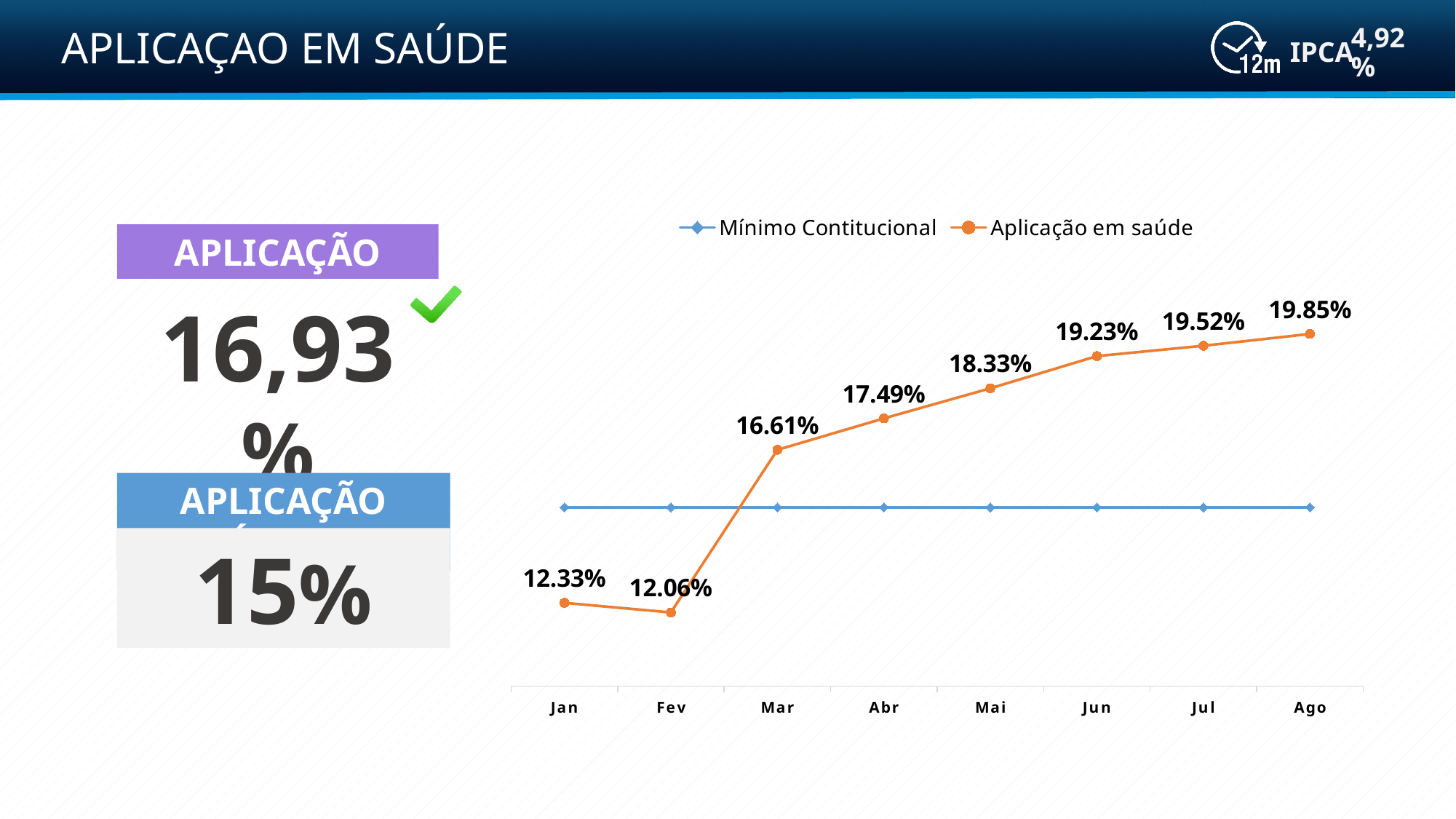
In which month is Aplicação em saúde highest? Ago Which series in the legend is drawn in orange? Aplicação em saúde What is the difference between the Aplicação em saúde values for Ago and Jan? 7.52% How many months are plotted along the x axis of the chart? 8 How many series does the chart legend list? 2 What kind of chart is shown on the slide? line chart In which month is Aplicação em saúde lowest? Fev What is the value of Aplicação em saúde in Mar? 16.61% What is the value of Aplicação em saúde in Jan? 12.33% Which is larger, the Aplicação em saúde value in Mai or in Abr? Mai Does the Aplicação em saúde series rise or fall from Fev to Ago? rise What is the value of Aplicação em saúde in Ago? 19.85%